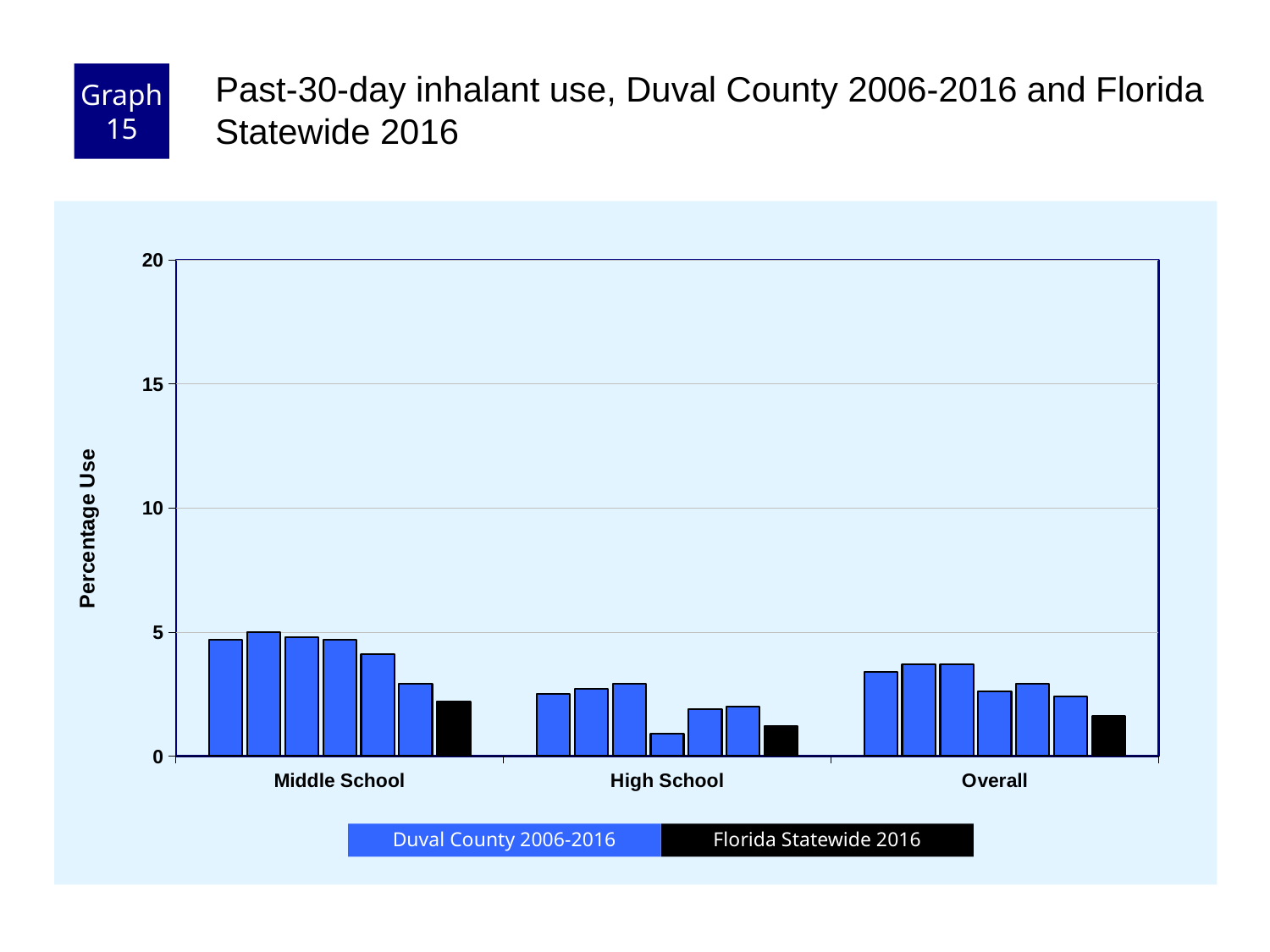
What is the label on the y axis? Percentage Use What kind of chart is shown on the slide? bar chart Which category has the highest Florida Statewide 2016 value? Middle School How many categories are shown along the x axis? 3 How many series does the legend list? 2 Is the Florida Statewide 2016 value for High School greater or less than 5? less Are all the bars for Overall greater or less than 5? less Which category has the lowest Florida Statewide 2016 value? High School Which is larger, the Florida Statewide 2016 value for Overall or for High School? Overall What is the title of the chart? Past-30-day inhalant use, Duval County 2006-2016 and Florida Statewide 2016 Which is larger, the Florida Statewide 2016 value for Middle School or for High School? Middle School Is the Florida Statewide 2016 value for Middle School greater or less than 5? less